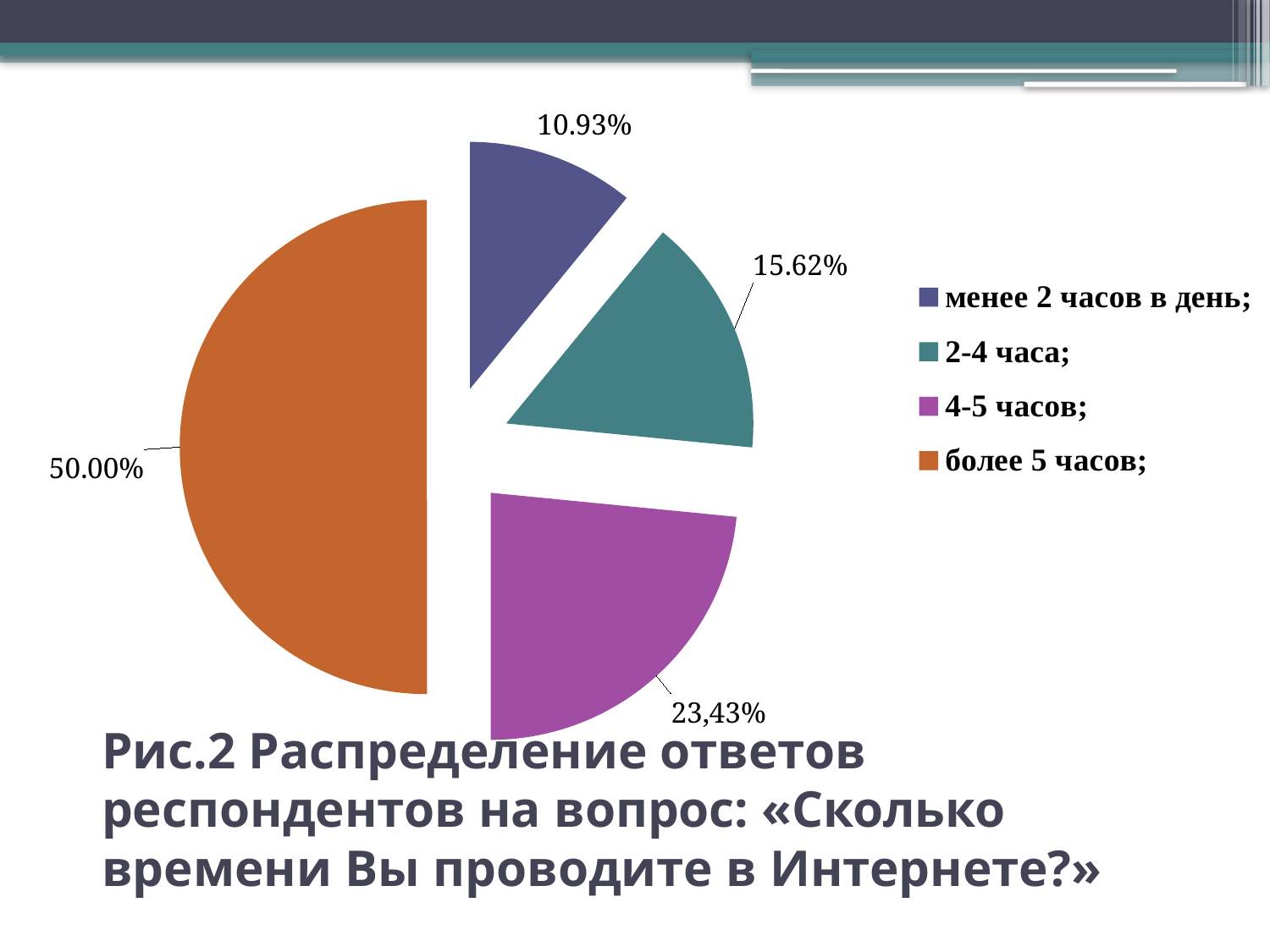
Which is larger: the share for "2-4 часа" or the share for "4-5 часов"? 4-5 часов What share of respondents answered "2-4 часа"? 15.62% What colour is the slice for "более 5 часов"? orange What is the difference in percentage points between the "более 5 часов" slice and the "менее 2 часов в день" slice? 39.07 What share of respondents answered "4-5 часов"? 23,43% How many slices does the pie chart have? 4 Which answer option has the smallest share of the pie? менее 2 часов в день What kind of chart is shown on the slide? pie chart How many entries does the legend list? 4 Which answer option has the largest share of the pie? более 5 часов What share of respondents answered "менее 2 часов в день"? 10.93% What share of respondents answered "более 5 часов"? 50.00%